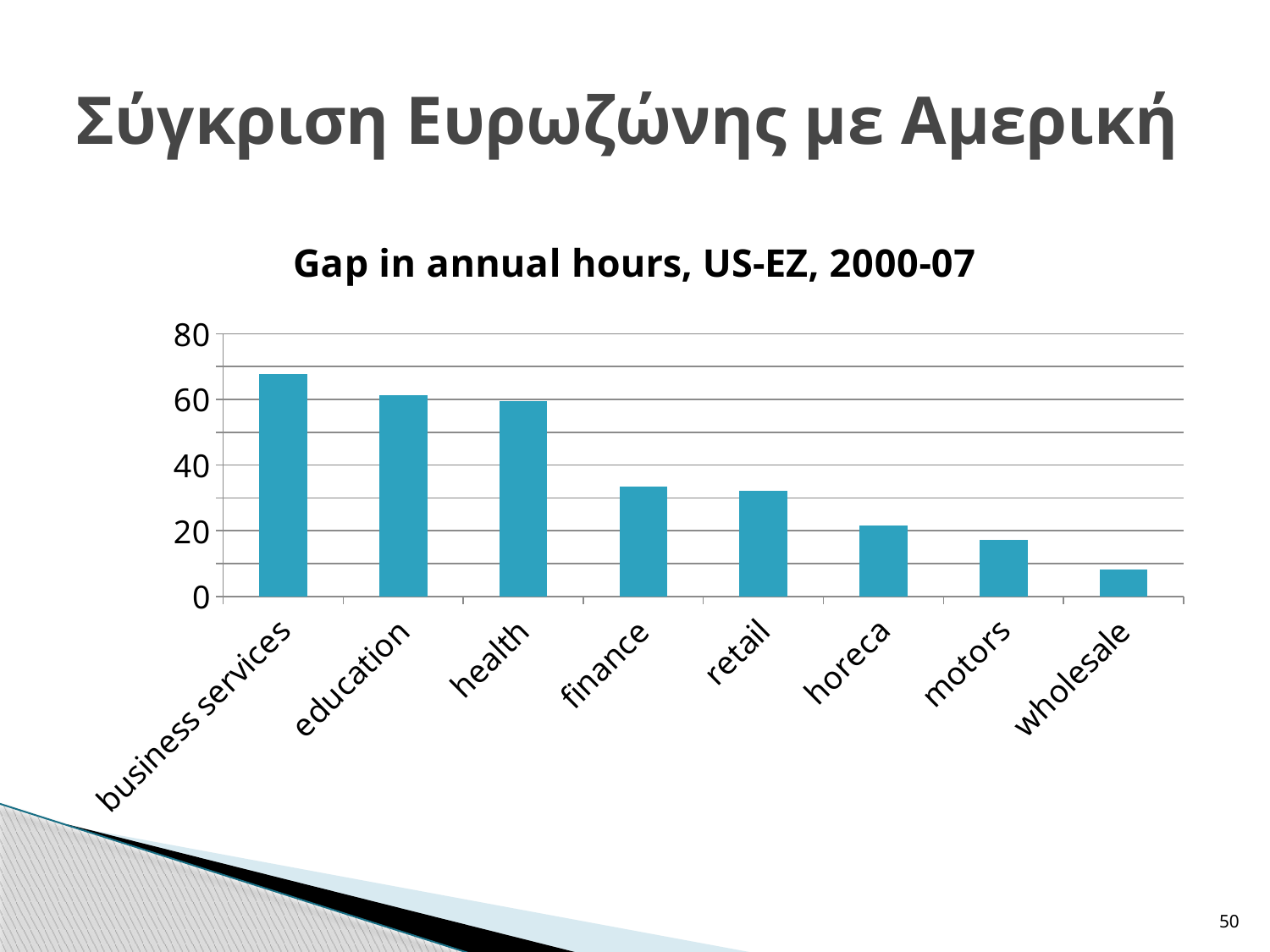
What is the title of the chart? Gap in annual hours, US-EZ, 2000-07 Which category has the highest value? business services How many categories are plotted in the chart? 8 Is the value for finance greater or less than 40? less Which is larger, the value for business services or the value for education? business services Is the value for business services greater or less than 60? greater Is the value for health greater or less than 40? greater Which category has the lowest value? wholesale What kind of chart is shown on the slide? bar chart Do the values rise or fall moving from left to right along the x axis? fall Which is larger, the value for health or the value for finance? health